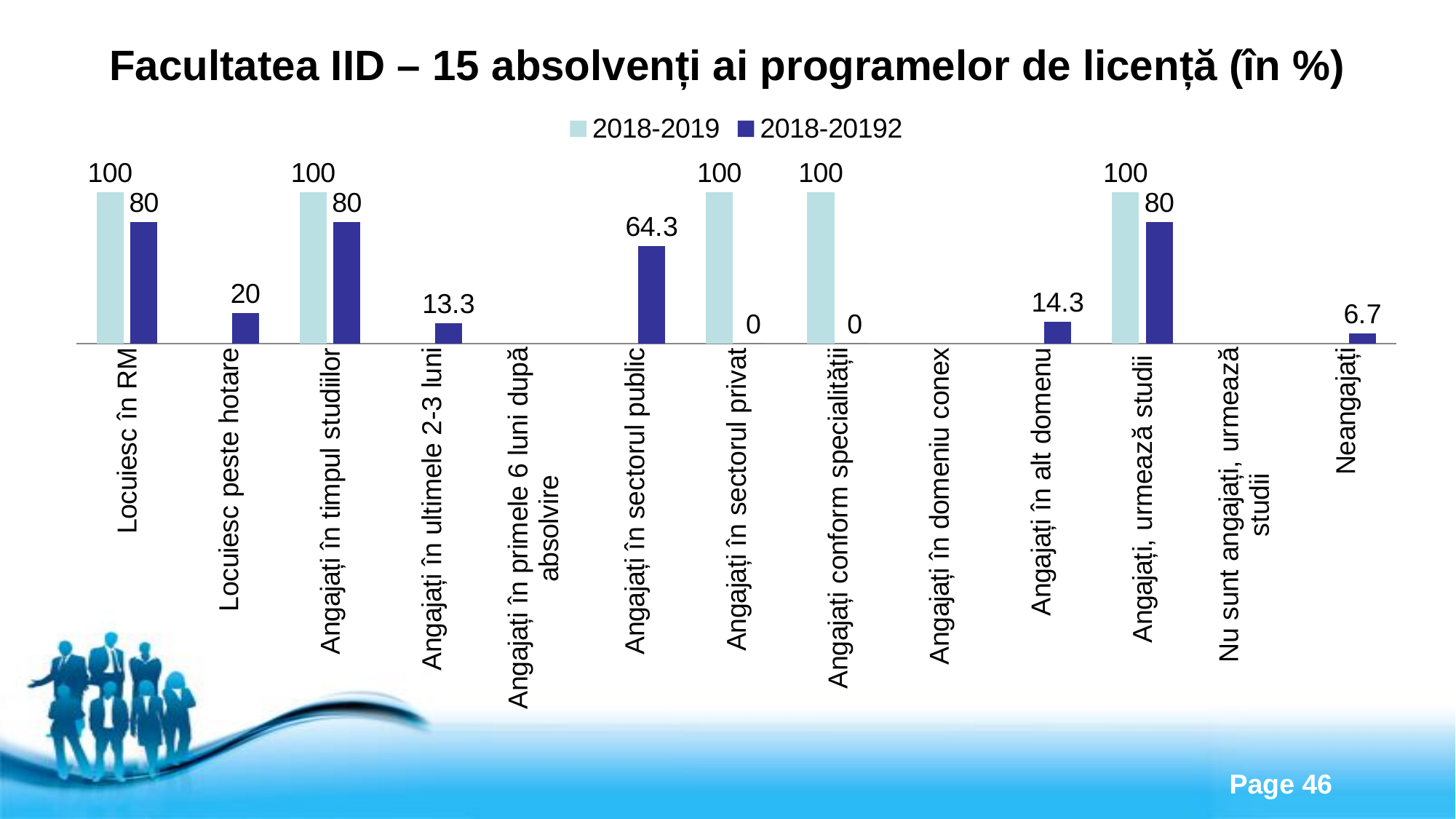
What is the 2018-20192 value for "Neangajați"? 6.7 What is the 2018-20192 value for "Angajați în sectorul public"? 64.3 What is the 2018-2019 value for "Angajați conform specialității"? 100 How many series does the legend list? 2 What is the 2018-20192 value for "Locuiesc în RM"? 80 What is the title of the chart? Facultatea IID – 15 absolvenți ai programelor de licență (în %) How many categories are shown on the x axis? 13 What is the difference between the 2018-2019 and 2018-20192 values for "Angajați în timpul studiilor"? 20 Which category has the lowest non-zero 2018-20192 value? Neangajați Which is larger: the 2018-20192 value for "Locuiesc peste hotare" or for "Angajați în alt domenu"? Locuiesc peste hotare What type of chart is shown on the slide? bar chart What is the 2018-20192 value for "Angajați în ultimele 2-3 luni"? 13.3